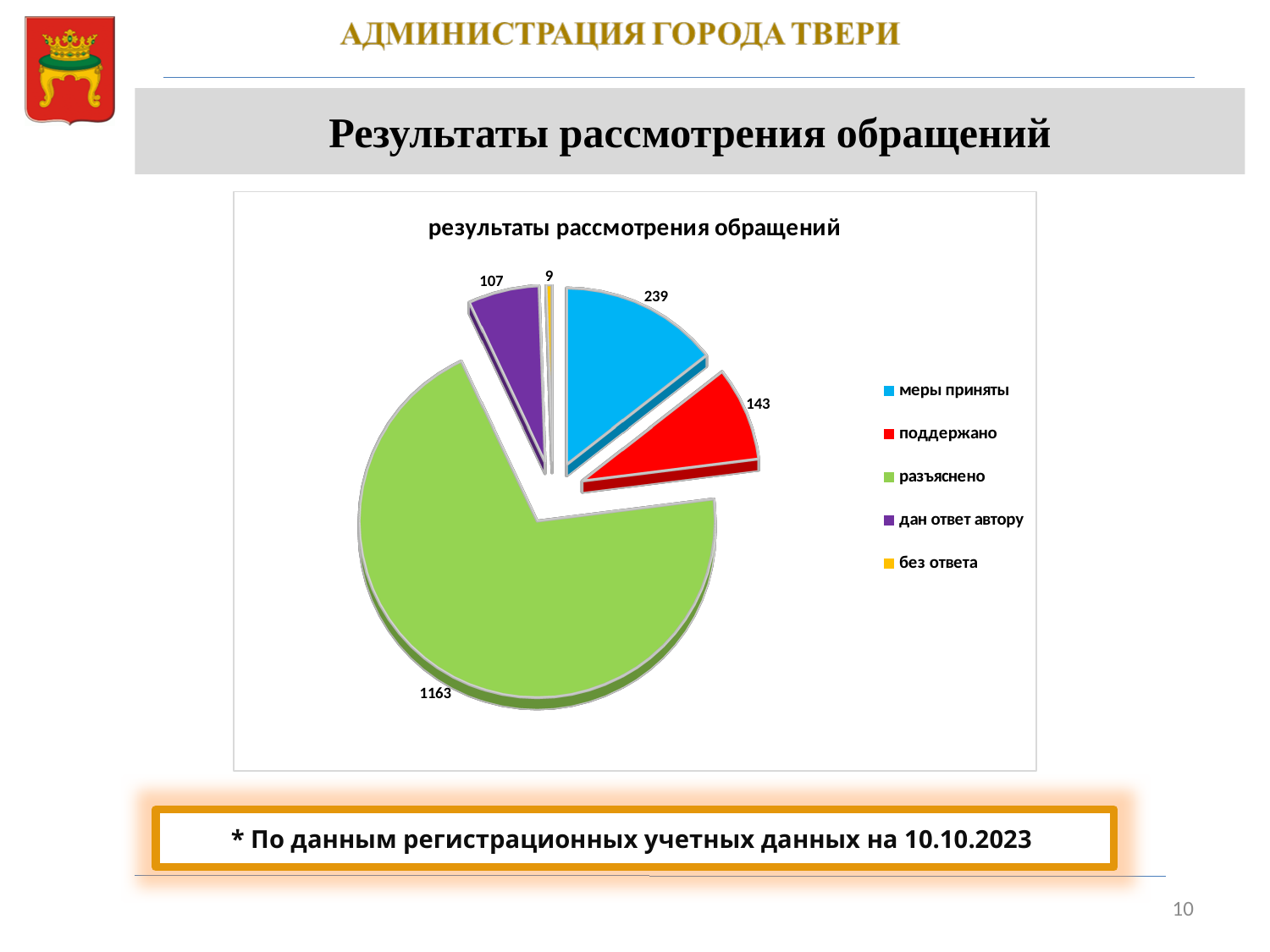
Which is larger, the value for «поддержано» or the value for «дан ответ автору»? поддержано What type of chart is shown on the slide? pie chart What is the value for «поддержано» in the pie chart? 143 What is the value for «меры приняты» in the pie chart? 239 Which category has the largest slice in the pie chart? разъяснено What is the value for «дан ответ автору» in the pie chart? 107 What is the difference between the values for «меры приняты» and «поддержано»? 96 How many categories does the legend of the pie chart list? 5 What is the value for «без ответа» in the pie chart? 9 What is the value for «разъяснено» in the pie chart? 1163 Which category has the smallest slice in the pie chart? без ответа What is the title of the chart? результаты рассмотрения обращений